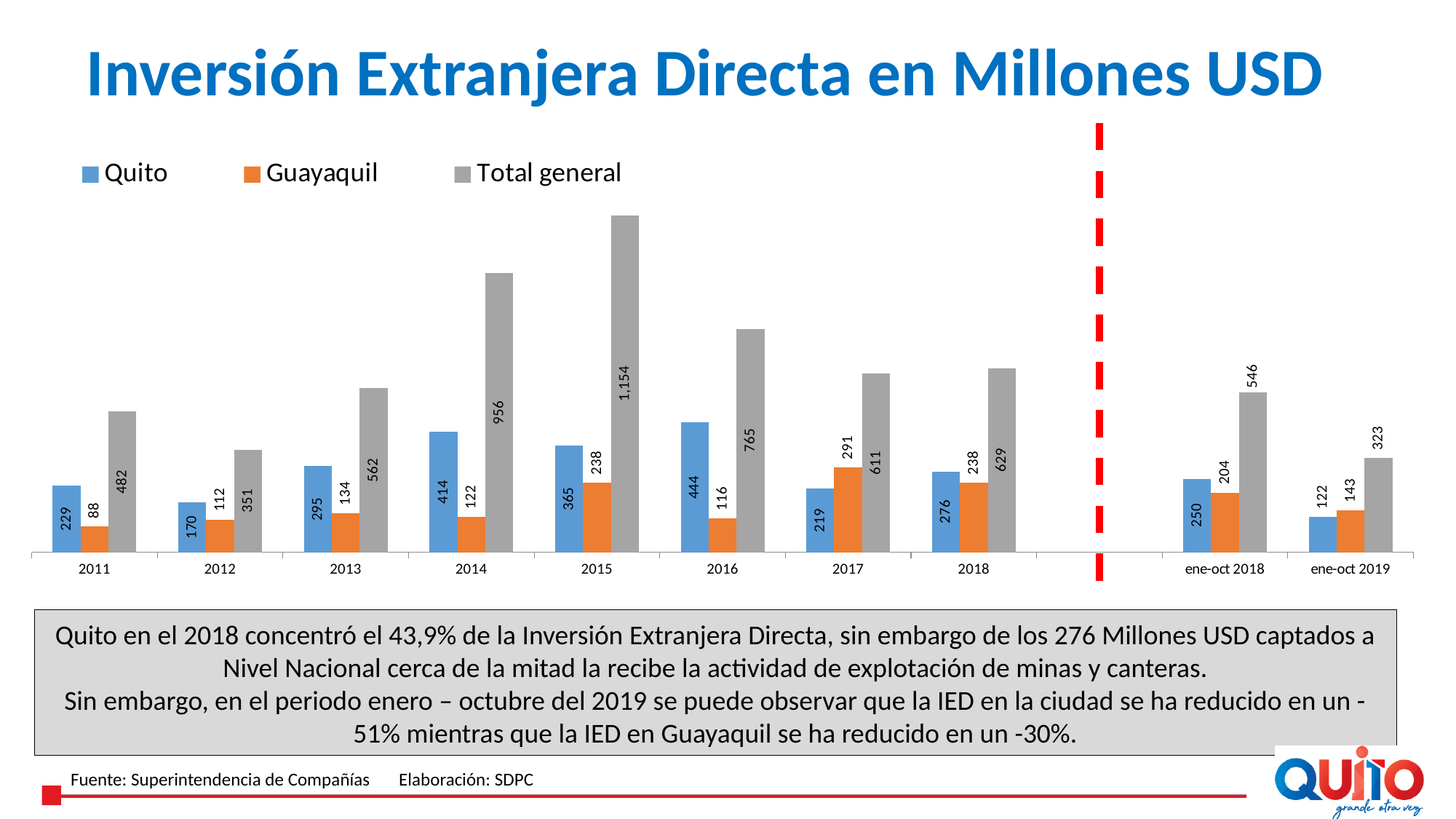
What is the difference between the Quito value and the Guayaquil value in 2014? 292 In which category is the Guayaquil value lowest? 2011 What is the value for Quito in ene-oct 2019? 122 How many series does the legend list? 3 What kind of chart is shown on the slide? Bar chart What is the Total general value for 2015? 1,154 Which is larger in 2017, the Quito value or the Guayaquil value? Guayaquil What is the title of the slide? Inversión Extranjera Directa en Millones USD How many categories are shown on the x axis? 10 What is the value for Guayaquil in 2017? 291 What is the value for Quito in 2016? 444 In which year is the Total general highest? 2015